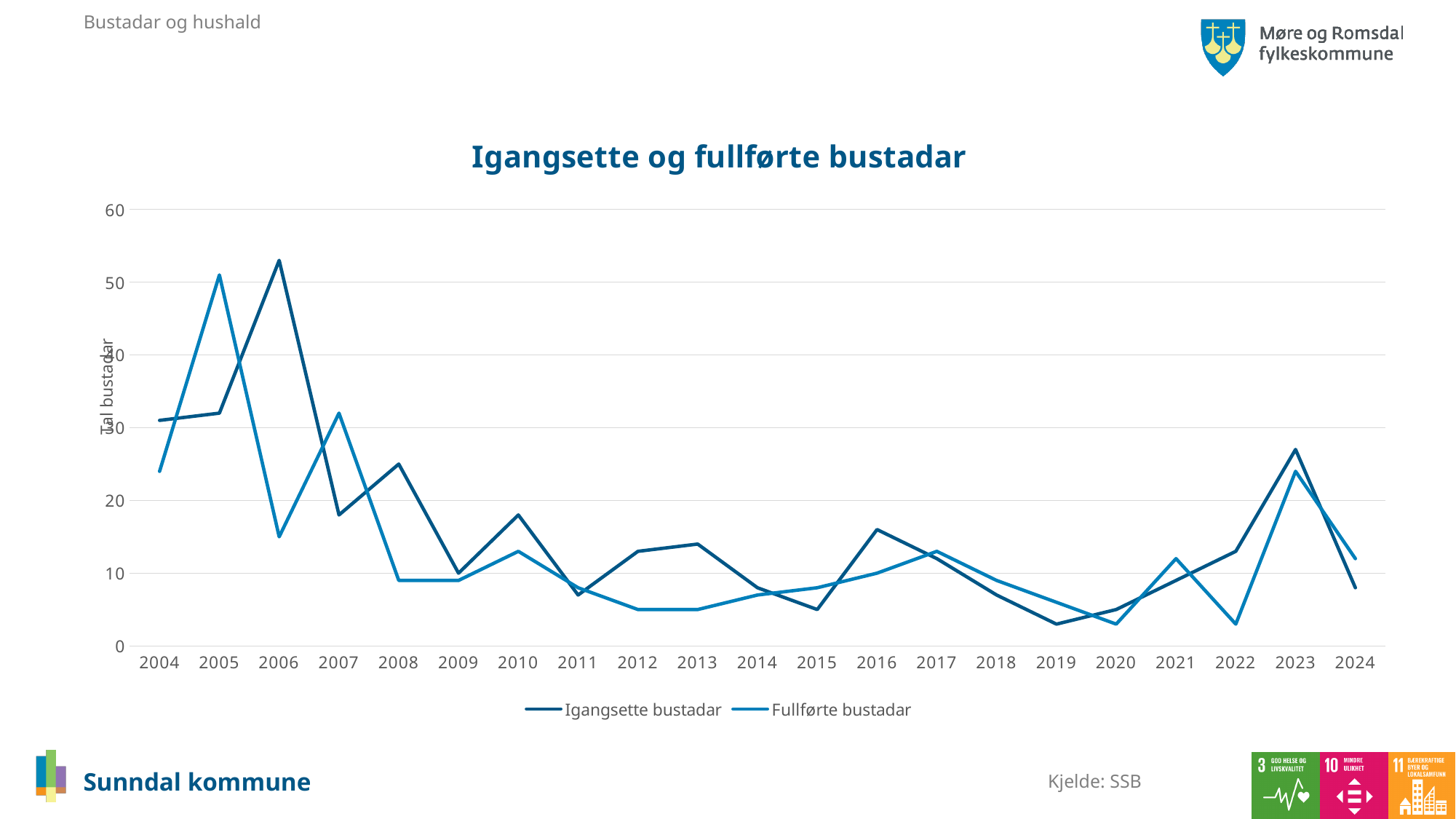
What kind of chart is shown on the slide? Line chart Is the value for Igangsette bustadar in 2019 greater or less than 10? less How many series does the legend list? 2 Is the value for Igangsette bustadar in 2006 greater or less than 50? greater In 2005, which series has the larger value, Igangsette bustadar or Fullførte bustadar? Fullførte bustadar In which year does the Igangsette bustadar series reach its highest value? 2006 What is the title of the chart? Igangsette og fullførte bustadar How many years are shown on the x axis? 21 Is the value for Fullførte bustadar in 2023 greater or less than 20? greater In which year does the Fullførte bustadar series reach its highest value? 2005 Does the Igangsette bustadar series rise or fall from 2019 to 2023? Rise